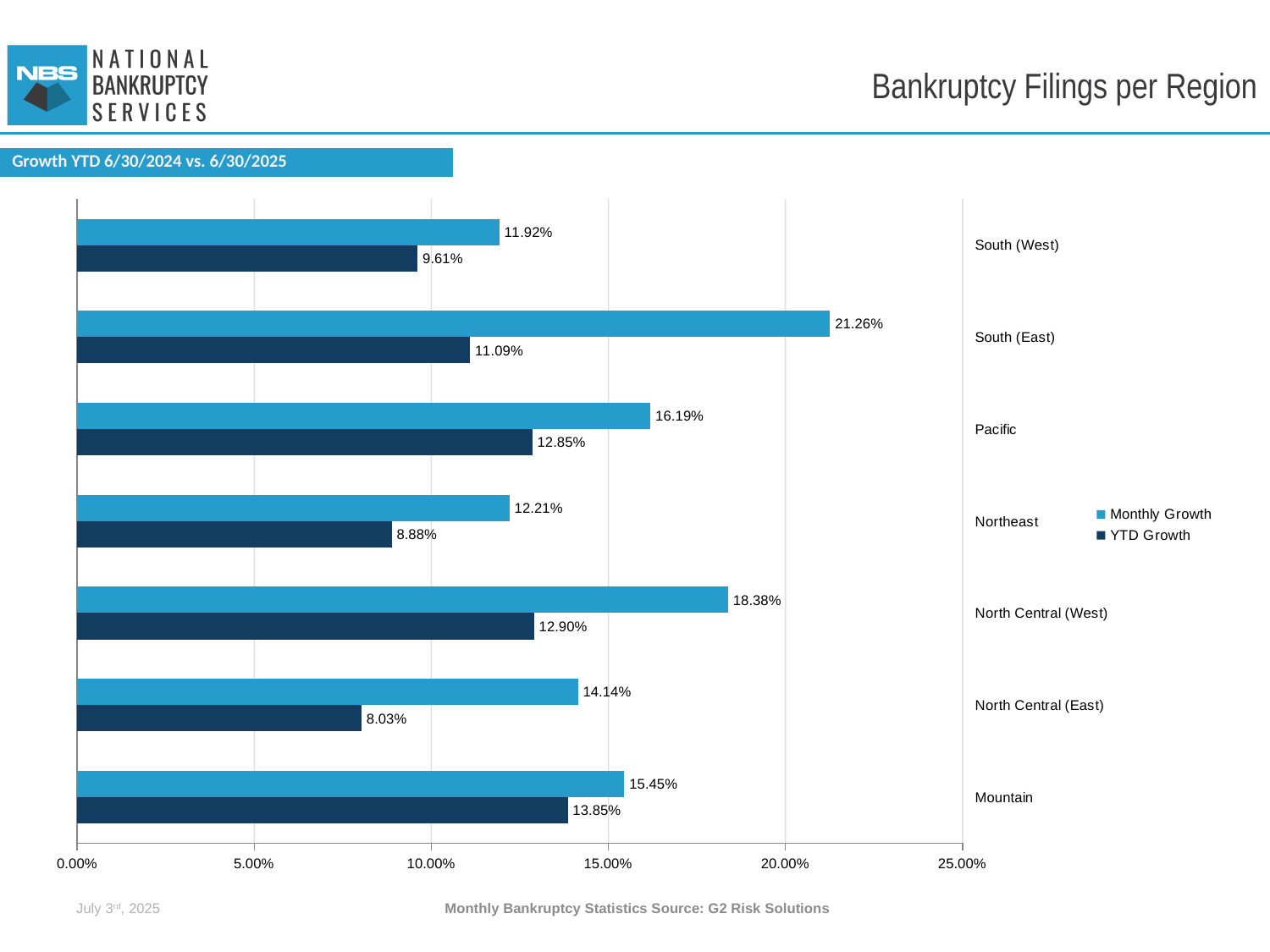
Which region has the highest Monthly Growth? South (East) What is the YTD Growth value for North Central (East)? 8.03% Which region has the lowest YTD Growth? North Central (East) How many series does the legend list? 2 How many regions are shown on the chart? 7 Is the YTD Growth value for South (West) greater or less than 10.00%? less What kind of chart is shown on the slide? Bar chart What is the Monthly Growth value for South (East)? 21.26% What is the title shown above the chart? Growth YTD 6/30/2024 vs. 6/30/2025 What is the YTD Growth value for Mountain? 13.85% What is the difference between Monthly Growth and YTD Growth for Pacific? 3.34% Which is larger: the Monthly Growth for North Central (West) or the Monthly Growth for Mountain? North Central (West)